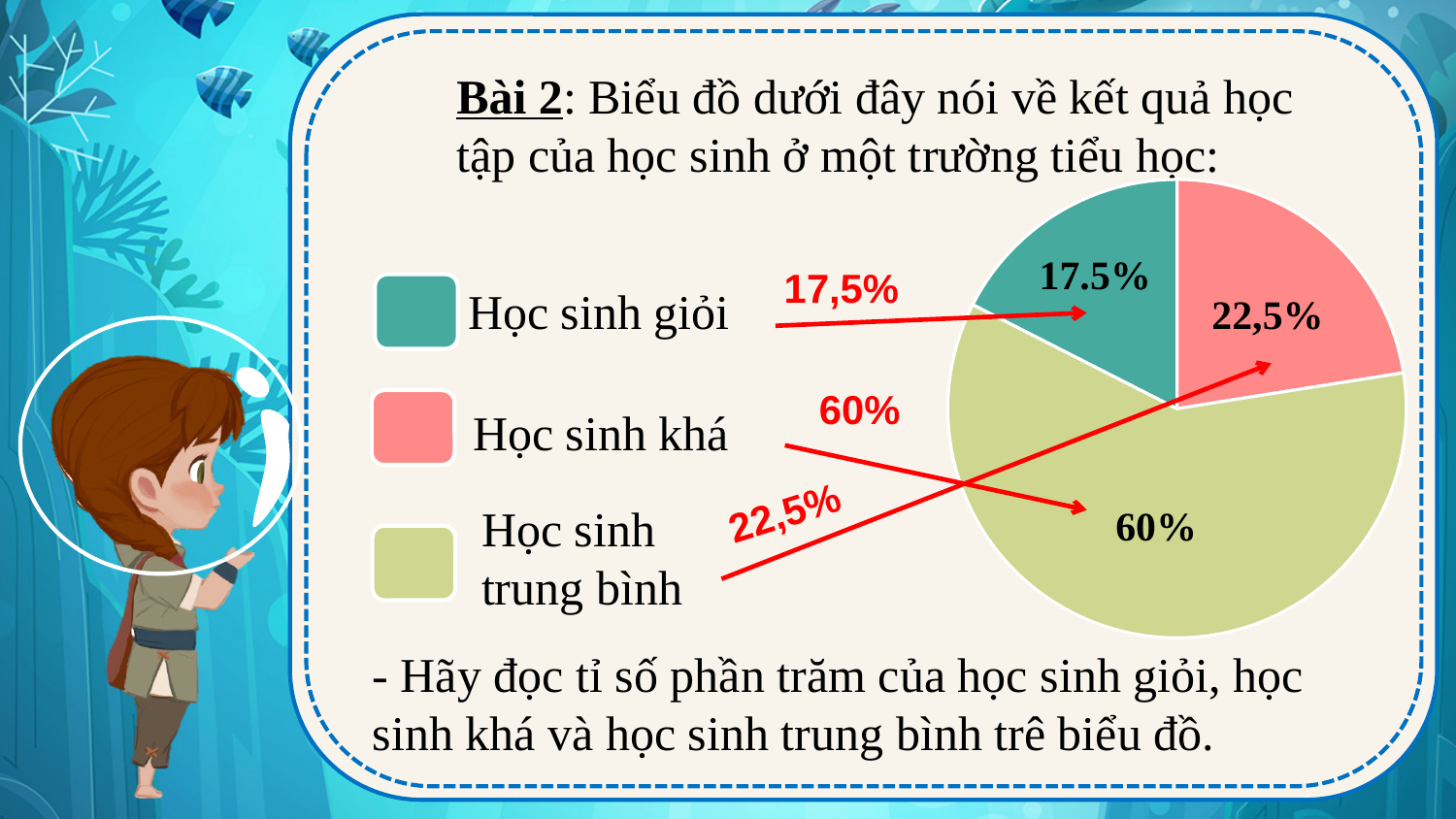
How many slices does the pie chart have? 3 What percentage is shown on the pie slice for Học sinh giỏi? 17.5% Which category has the smallest share of the pie chart? Học sinh giỏi What percentage is shown for Học sinh trung bình in the pie chart? 60% Which category has the largest share of the pie chart? Học sinh trung bình What percentage is shown for Học sinh khá in the pie chart? 22,5% Which is larger in the pie chart: Học sinh khá or Học sinh giỏi? Học sinh khá How many entries does the legend of the pie chart list? 3 What kind of chart is shown on the slide? pie chart What is the difference between the share of Học sinh trung bình and the share of Học sinh khá? 37,5% Which colour represents Học sinh trung bình in the pie chart? light green Which colour represents Học sinh khá in the pie chart? pink